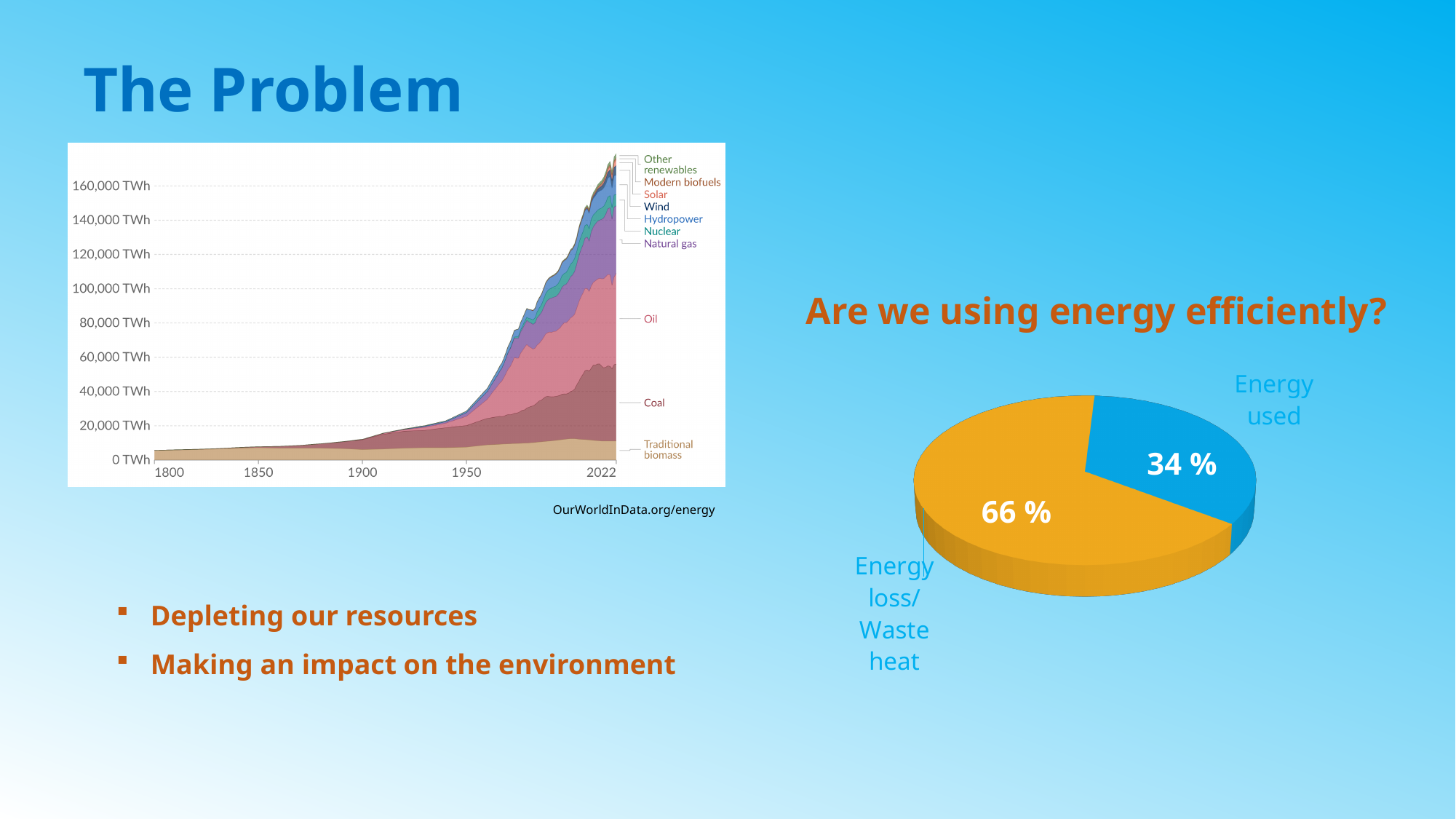
What kind of chart is shown on the left side of the slide? Area chart On the left chart, is the total energy consumption in 2022 greater or less than 160,000 TWh? greater What kind of chart is shown on the right side of the slide? Pie chart On the pie chart on the right, which slice is the largest? Energy loss/Waste heat On the left chart, is the total energy consumption in 1950 greater or less than 40,000 TWh? less On the left chart, how many energy sources are listed in the legend? 10 On the left chart, does total energy consumption rise or fall from 1800 to 2022? Rise On the pie chart on the right, how many slices are there? 2 On the pie chart on the right, which slice is the smallest? Energy used On the pie chart on the right, what is the difference in percentage points between Energy loss/Waste heat and Energy used? 32 % On the pie chart on the right, what percentage is labelled for Energy loss/Waste heat? 66 % On the pie chart on the right, what percentage is labelled for Energy used? 34 %